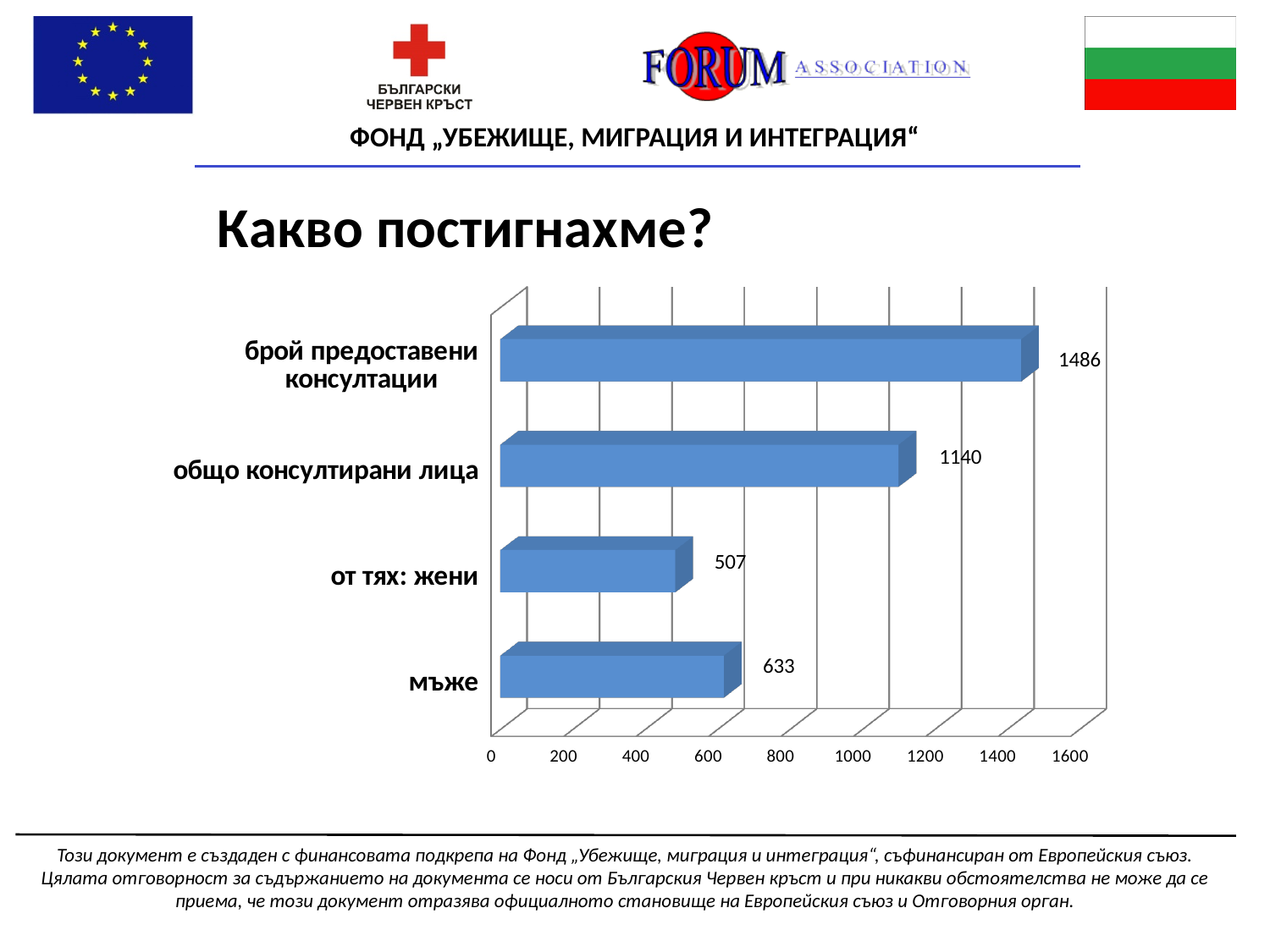
What kind of chart is shown on the slide? bar chart How many categories are shown in the chart? 4 Which is larger, the value for "мъже" or the value for "от тях: жени"? мъже What is the value for "общо консултирани лица"? 1140 What is the value for "мъже"? 633 Which category has the lowest value? от тях: жени Is the value for "общо консултирани лица" greater or less than 1000? greater What is the difference between "брой предоставени консултации" and "общо консултирани лица"? 346 Which category has the highest value? брой предоставени консултации What is the value for "от тях: жени"? 507 What is the value for "брой предоставени консултации"? 1486 What is the difference between the values for "мъже" and "от тях: жени"? 126